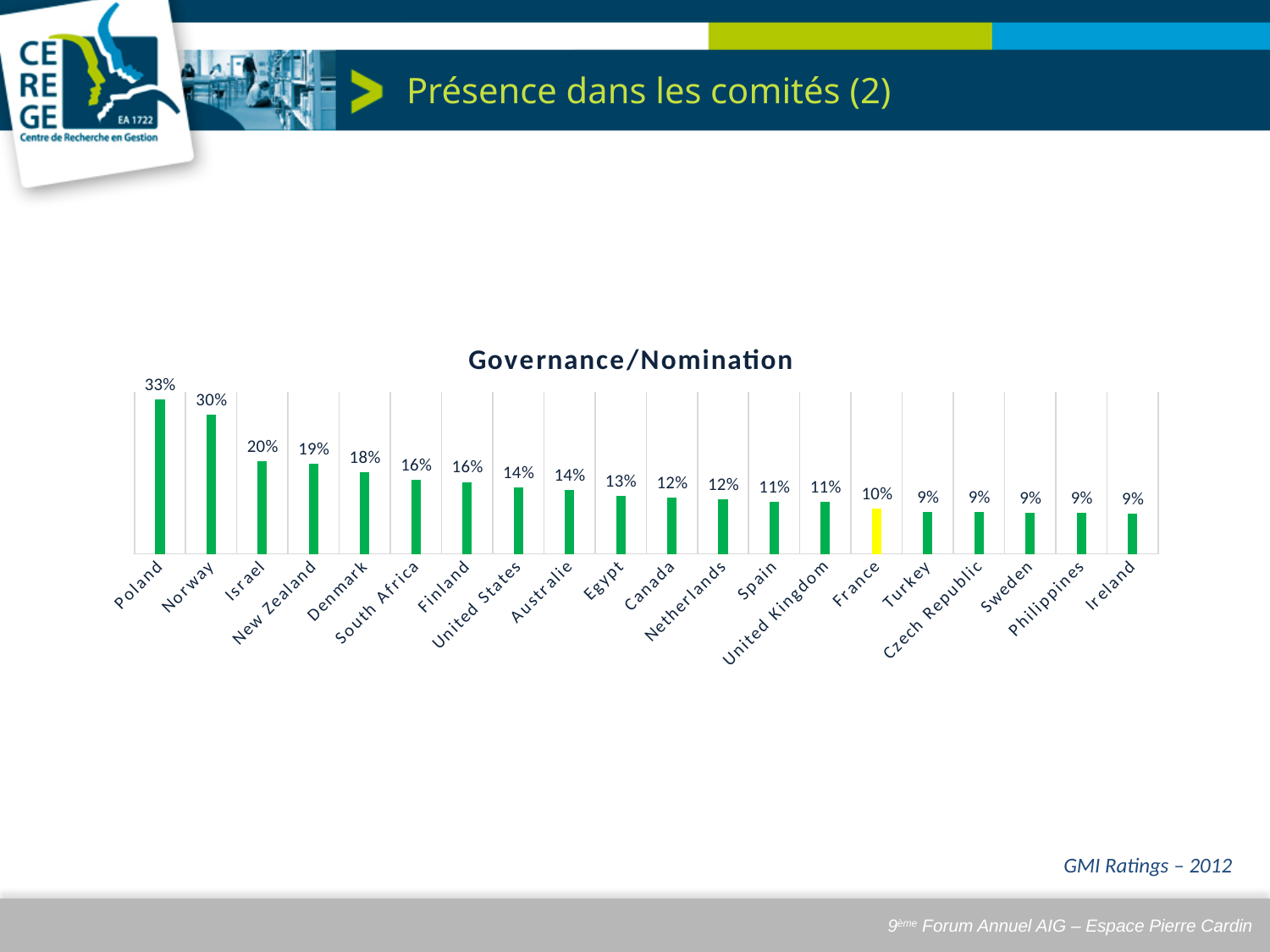
Which country has the highest value? Poland What is the difference between the values for Israel and France? 10% What is the value for United Kingdom? 11% What is the difference between the values for Poland and Norway? 3% What is the value for France? 10% What is the title of the chart? Governance/Nomination Which is larger, the value for Egypt or the value for Spain? Egypt What is the value for Denmark? 18% How many countries are shown in the chart? 20 What kind of chart is shown on the slide? Bar chart Which is larger, the value for Norway or the value for Israel? Norway What is the value for Poland? 33%